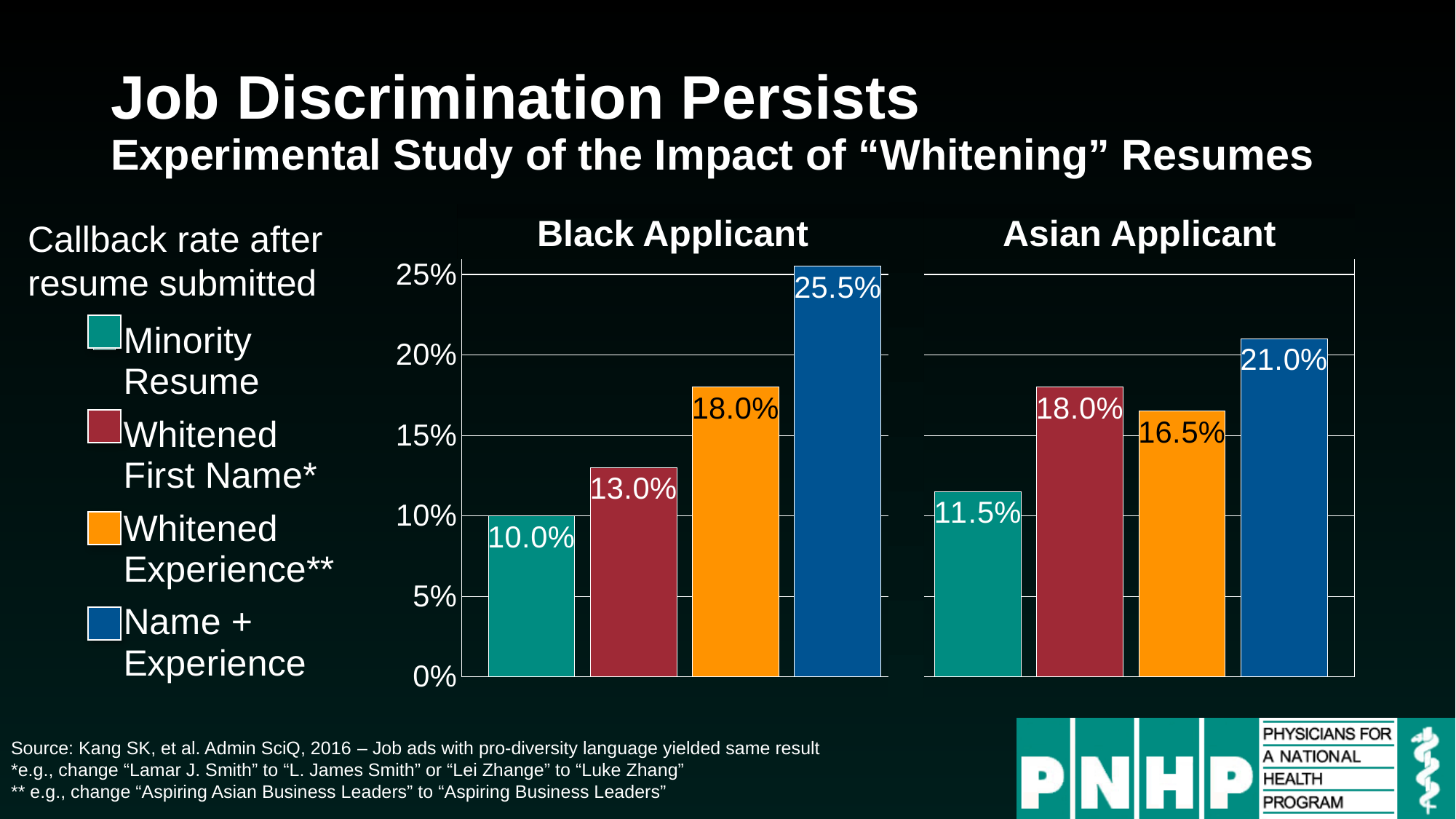
In the Black Applicant chart, what is the difference between the Name + Experience callback rate and the Minority Resume callback rate? 15.5% In the Asian Applicant chart, which is larger: the callback rate for Whitened First Name or for Whitened Experience? Whitened First Name How many bars are shown in the Asian Applicant chart? 4 In the Black Applicant chart, is the callback rate for Whitened First Name greater or less than 15%? less In the Asian Applicant chart, what is the callback rate for Whitened First Name? 18.0% How many resume types does the legend list? 4 In the Asian Applicant chart, what is the callback rate for Whitened Experience? 16.5% In the Asian Applicant chart, which resume type has the lowest callback rate? Minority Resume In the Asian Applicant chart, what is the difference between the Whitened First Name and Whitened Experience callback rates? 1.5% What kind of chart is the Black Applicant chart? bar chart In the Black Applicant chart, what is the callback rate for the Minority Resume? 10.0% In the Black Applicant chart, which resume type has the highest callback rate? Name + Experience